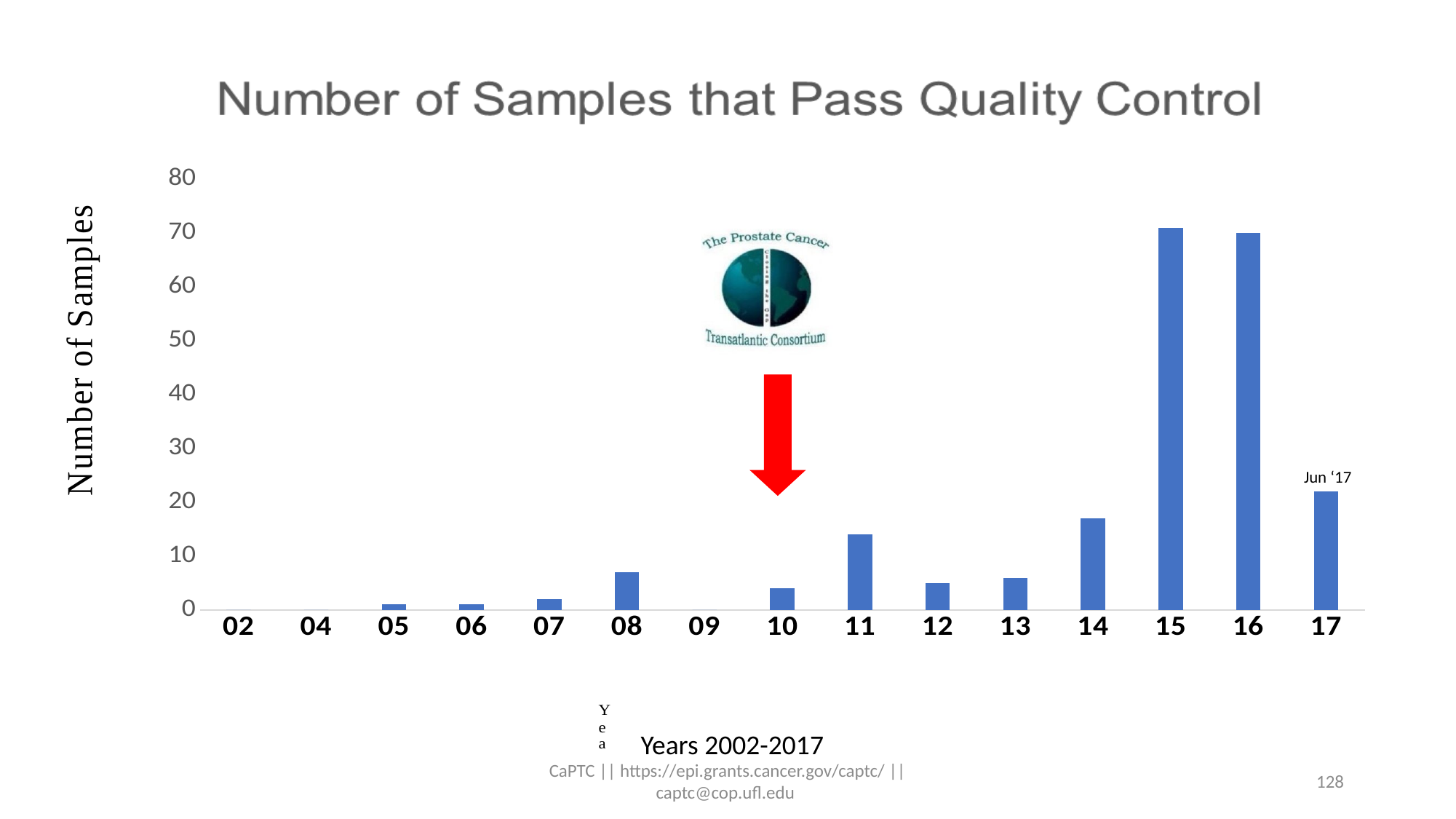
What is the label on the vertical axis of the chart? Number of Samples What is the title of the chart? Number of Samples that Pass Quality Control Which has a higher value, 14 or 11? 14 Is the value for 17 greater or less than 20? greater What type of chart is shown on the slide? Bar chart Is the value for 14 greater or less than 10? greater Which has a higher value, 08 or 10? 08 Is the value for 11 greater or less than 10? greater Do the values generally rise or fall from 02 to 16? Rise How many year categories are shown on the x axis of the chart? 15